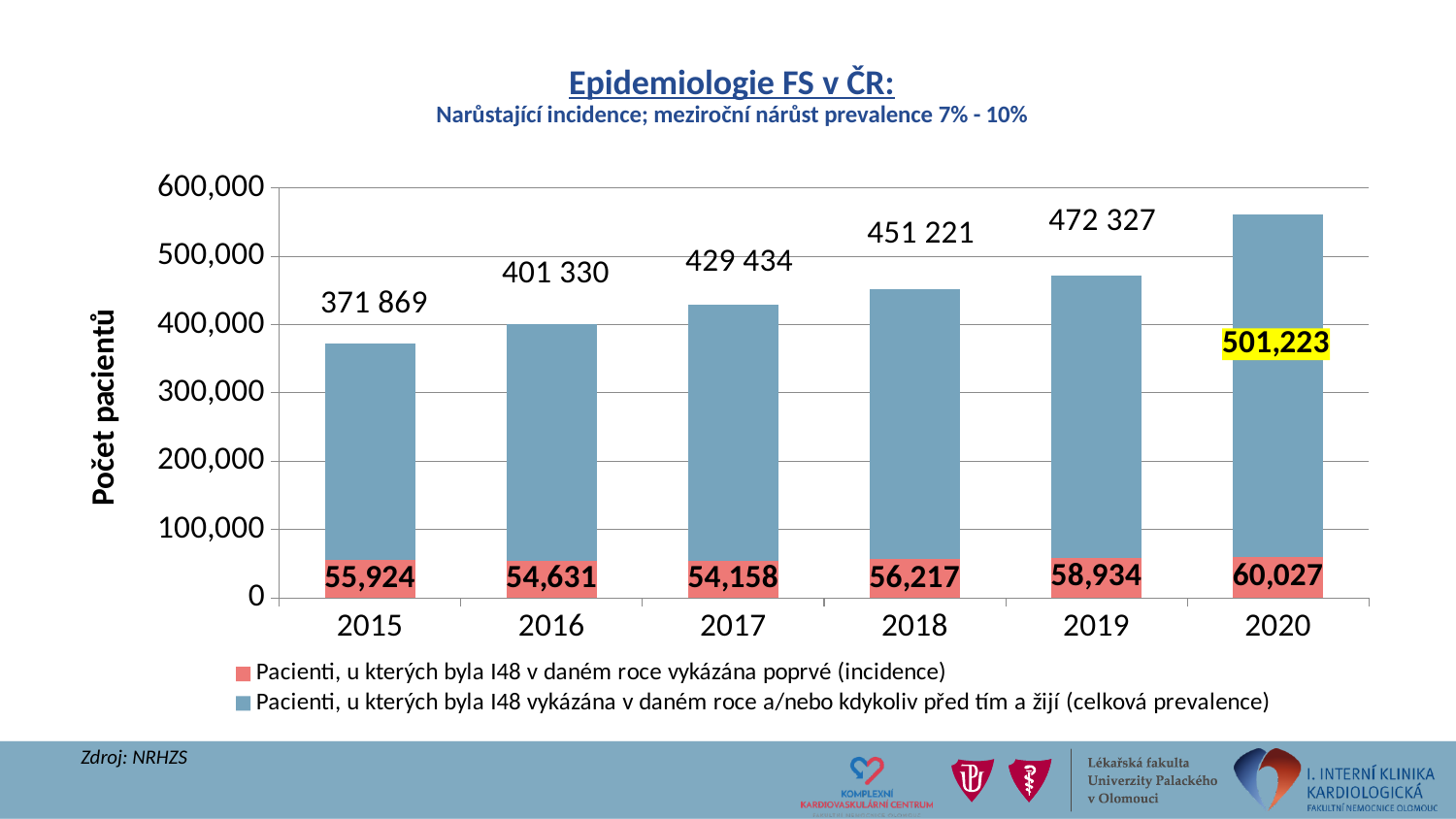
What is the incidence value (red segment) for 2015? 55,924 What is the incidence value (red segment) for 2020? 60,027 Which year has the larger incidence value, 2016 or 2018? 2018 What kind of chart is shown on the slide? Bar chart What value is labelled for the prevalence series in 2018? 451 221 How many years are shown on the x axis? 6 What value is labelled for the prevalence series in 2019? 472 327 What is the difference between the incidence values for 2020 and 2019? 1,093 Do the prevalence values rise or fall from 2015 to 2020? Rise Which year has the lowest incidence value (red segment)? 2017 How many series does the legend list? 2 Which year has the highest incidence value (red segment)? 2020